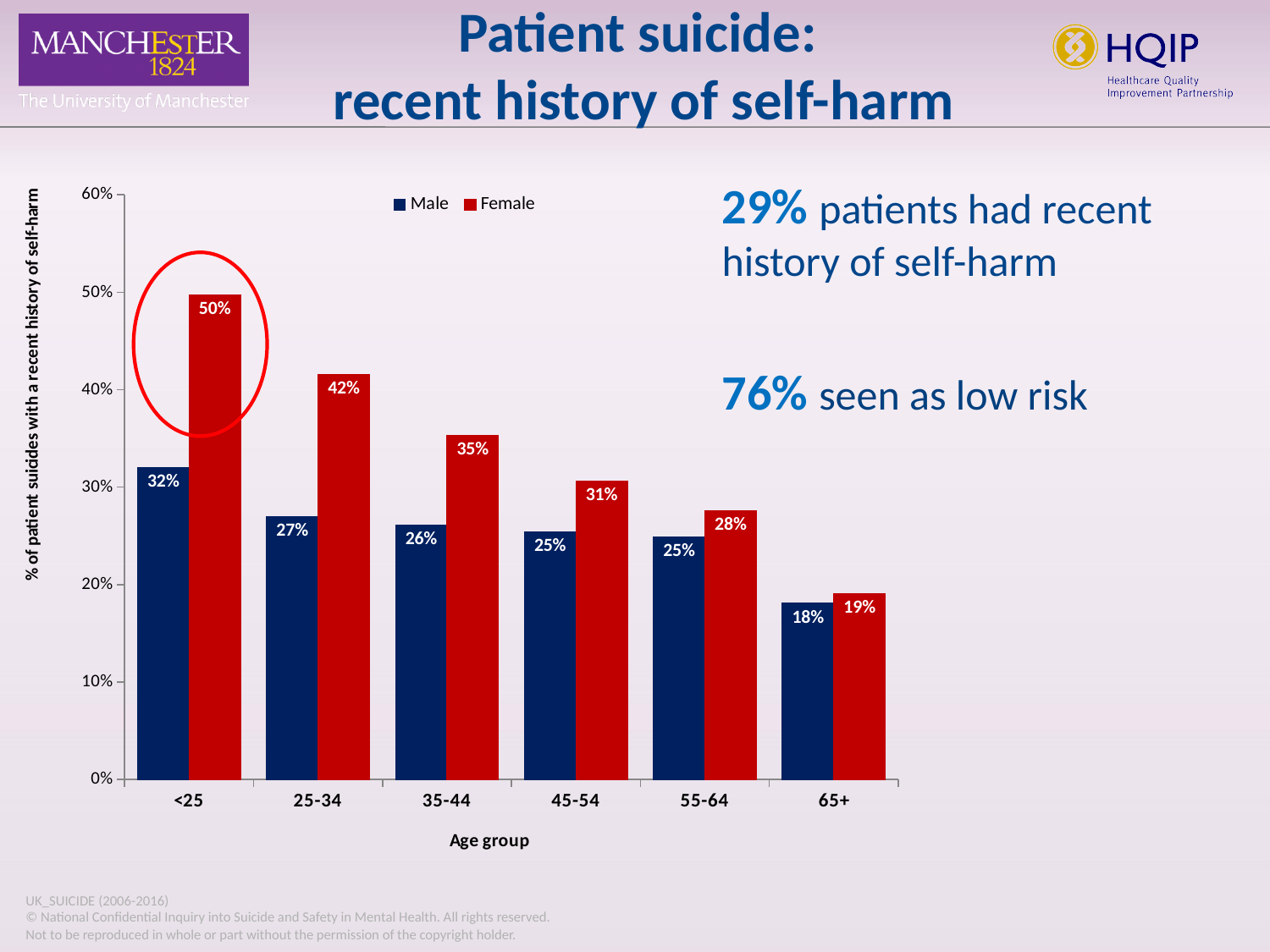
Which age group has the lowest Male value? 65+ How many series does the legend list? 2 What is the value for Female in the <25 age group? 50% What kind of chart is shown on the slide? bar chart Do the Female values rise or fall as age group increases along the x axis? fall What is the value for Male in the 25-34 age group? 27% What is the difference between the Female and Male values in the <25 age group? 18% Which is larger in the 35-44 age group, the Male value or the Female value? Female Which age group has the highest Female value? <25 Is the Female value for the 25-34 age group greater or less than 40%? greater What is the value for Female in the 65+ age group? 19% How many age groups are shown on the x axis? 6